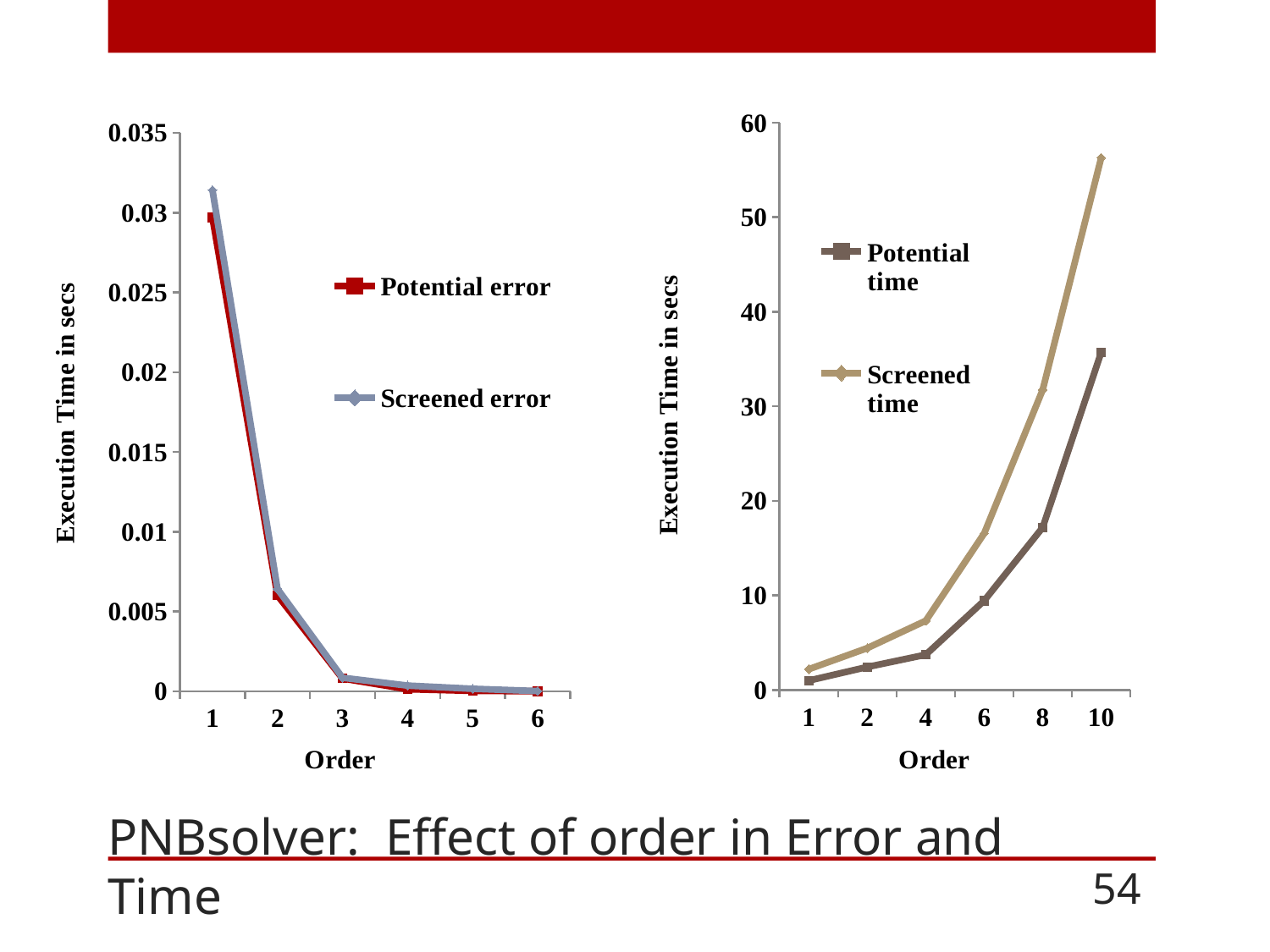
In the right chart, which series has the larger value at Order 10, Potential time or Screened time? Screened time How many series does the legend of the right chart (Potential time / Screened time) list? 2 In the left chart, is the Screened error value at Order 1 greater or less than 0.03? greater What is the label of the x axis on the left chart (Potential error / Screened error)? Order In the left chart, is the Potential error value at Order 3 greater or less than 0.005? less In the right chart, is the Potential time value at Order 8 greater or less than 20? less How many Order values are plotted along the x axis of the right chart (Potential time / Screened time)? 6 In the left chart (Potential error / Screened error), do the values rise or fall as Order increases? fall What kind of chart is the left chart (Potential error / Screened error)? line chart In the right chart (Potential time / Screened time), do the values rise or fall as Order increases? rise